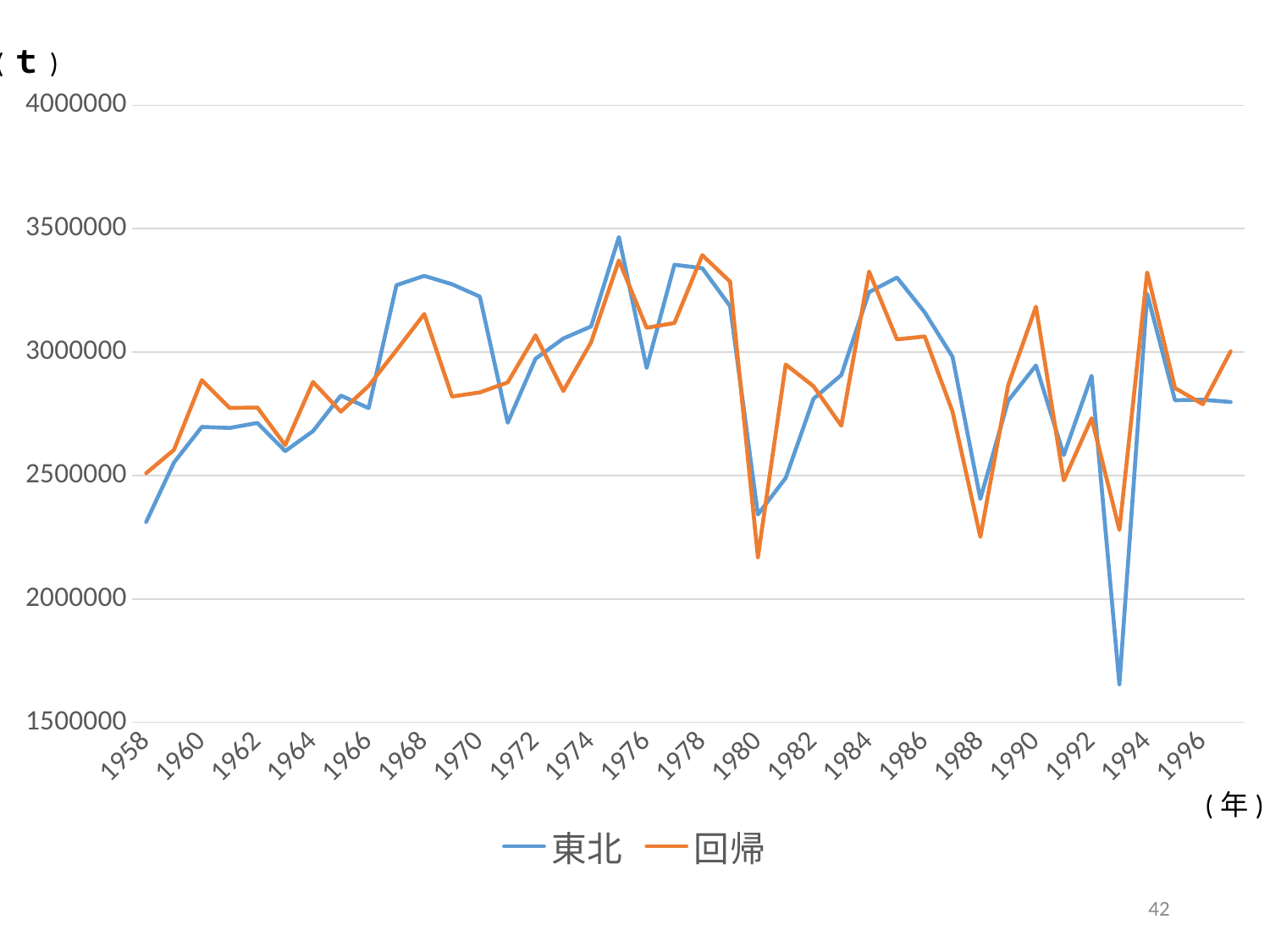
What kind of chart is shown on the slide? line chart Is the value for 回帰 in 1980 greater or less than 2500000? less In which year does the 東北 series reach its highest value? 1975 In 1993, which series has the larger value, 東北 or 回帰? 回帰 Is the value for 東北 in 1993 greater or less than 2000000? less Is the value for 東北 in 1958 greater or less than 2500000? less In which year does the 東北 series reach its lowest value? 1993 How many series does the legend list? 2 Does the 東北 series rise or fall from 1992 to 1993? fall What are the two series named in the legend? 東北 and 回帰 What unit is shown at the top of the vertical axis? t